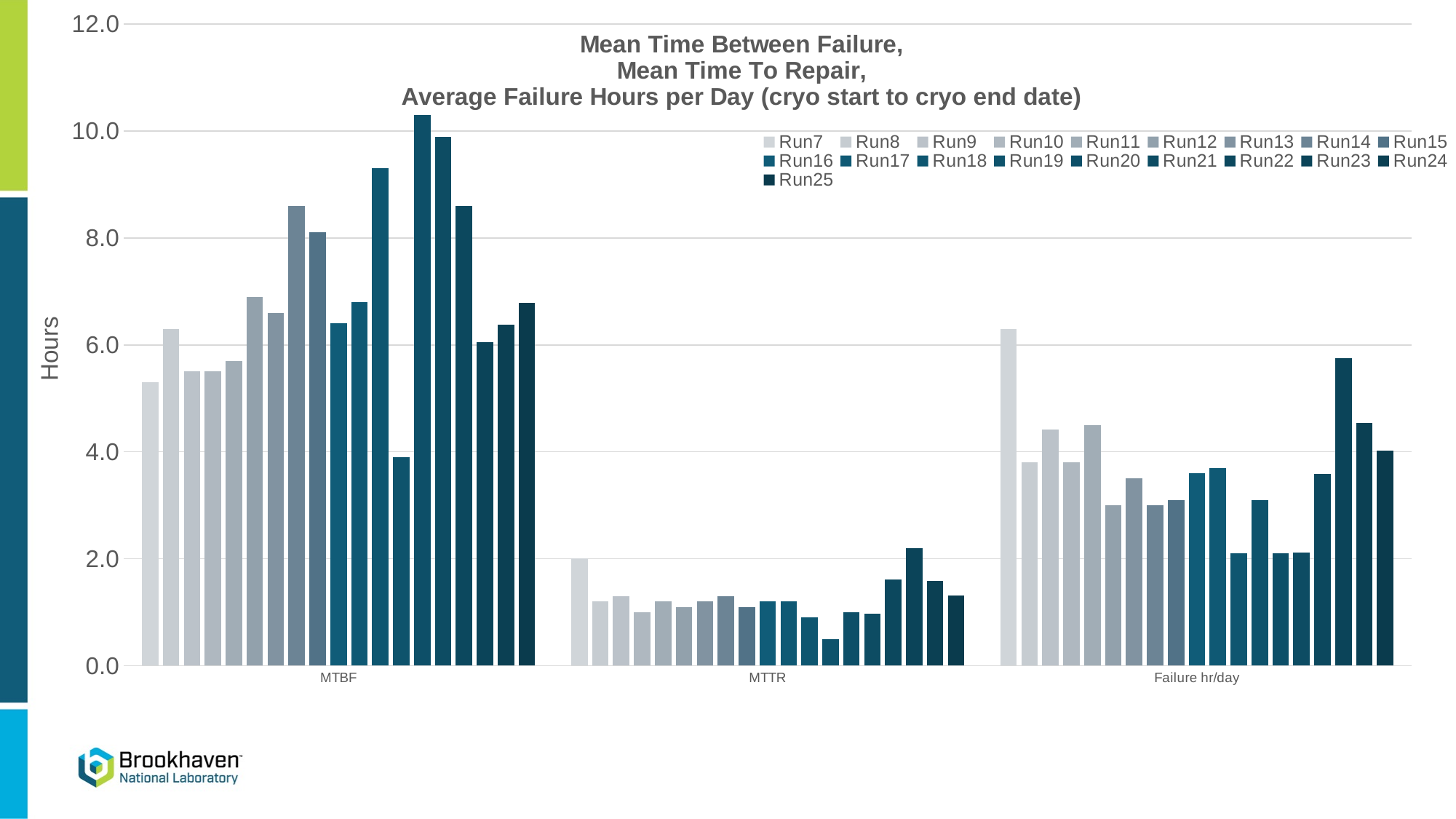
Is the tallest bar in the MTTR group greater or less than 4.0? less How many series does the chart's legend list? 19 Is the leftmost (Run7) bar in the MTBF group greater or less than 6.0? less Is the tallest bar in the MTBF group greater or less than 10.0? greater What is the label of the y axis? Hours What kind of chart is shown on the slide? bar chart Which category contains the tallest bar in the chart? MTBF What is the first series listed in the legend? Run7 How many categories are shown on the x axis of the chart? 3 Which category has the lowest bars overall? MTTR Is the tallest bar in the Failure hr/day group larger or smaller than the tallest bar in the MTBF group? smaller